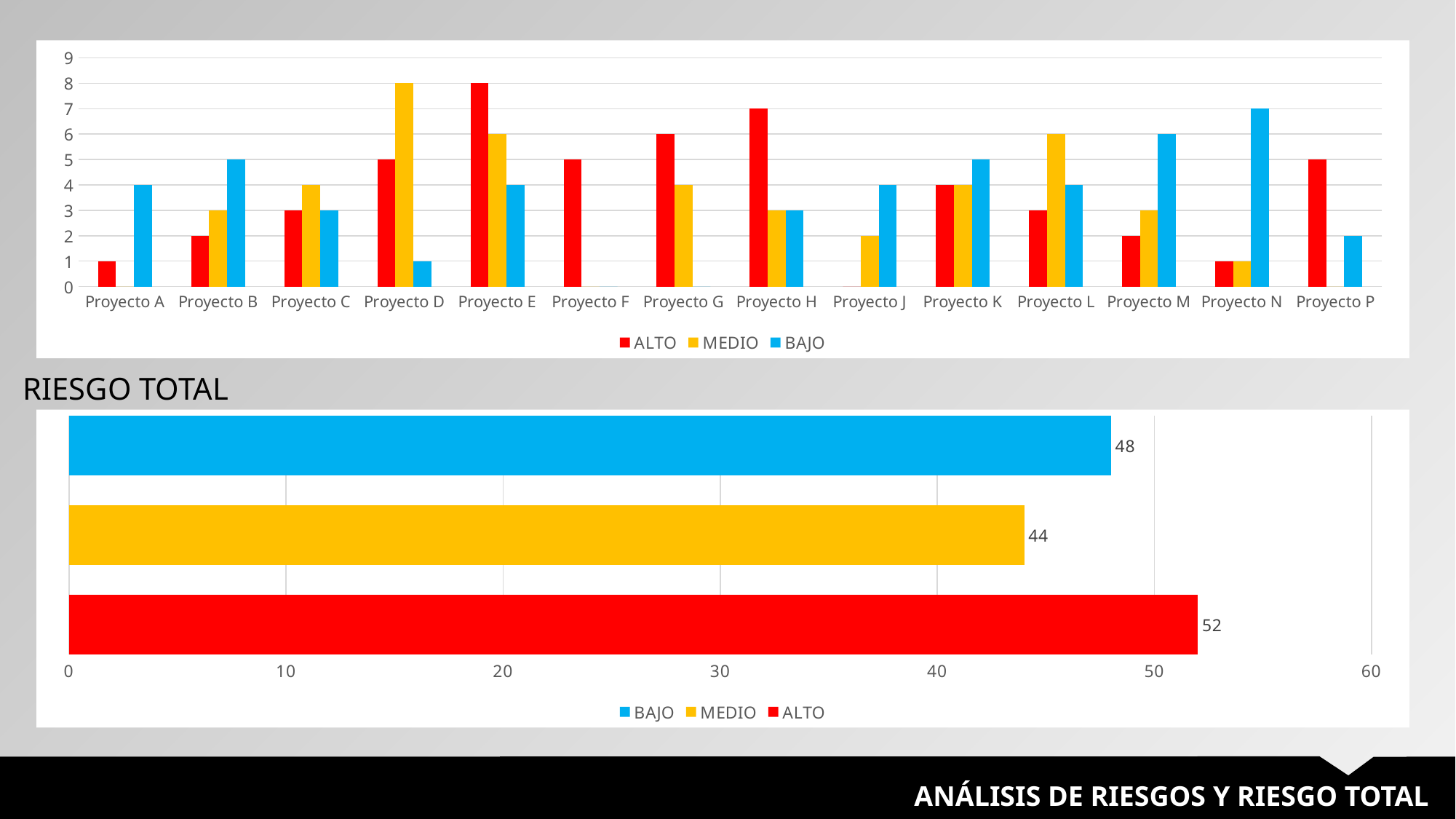
In the RIESGO TOTAL chart, what is the difference between the ALTO and BAJO values? 4 In the top chart, what is the ALTO value for Proyecto E? 8 How many series does the legend of the top chart list? 3 In the top chart, how many projects are shown on the x axis? 14 What kind of chart is the RIESGO TOTAL chart? Bar chart In the RIESGO TOTAL chart, which category has the highest value? ALTO In the top chart, which is larger for Proyecto D: the MEDIO value or the BAJO value? MEDIO In the top chart, is the BAJO value for Proyecto N greater or less than 5? greater In the RIESGO TOTAL chart, what is the value for MEDIO? 44 In the RIESGO TOTAL chart, what is the value for ALTO? 52 In the RIESGO TOTAL chart, which category has the lowest value? MEDIO In the RIESGO TOTAL chart, is the value for BAJO greater or less than 50? less